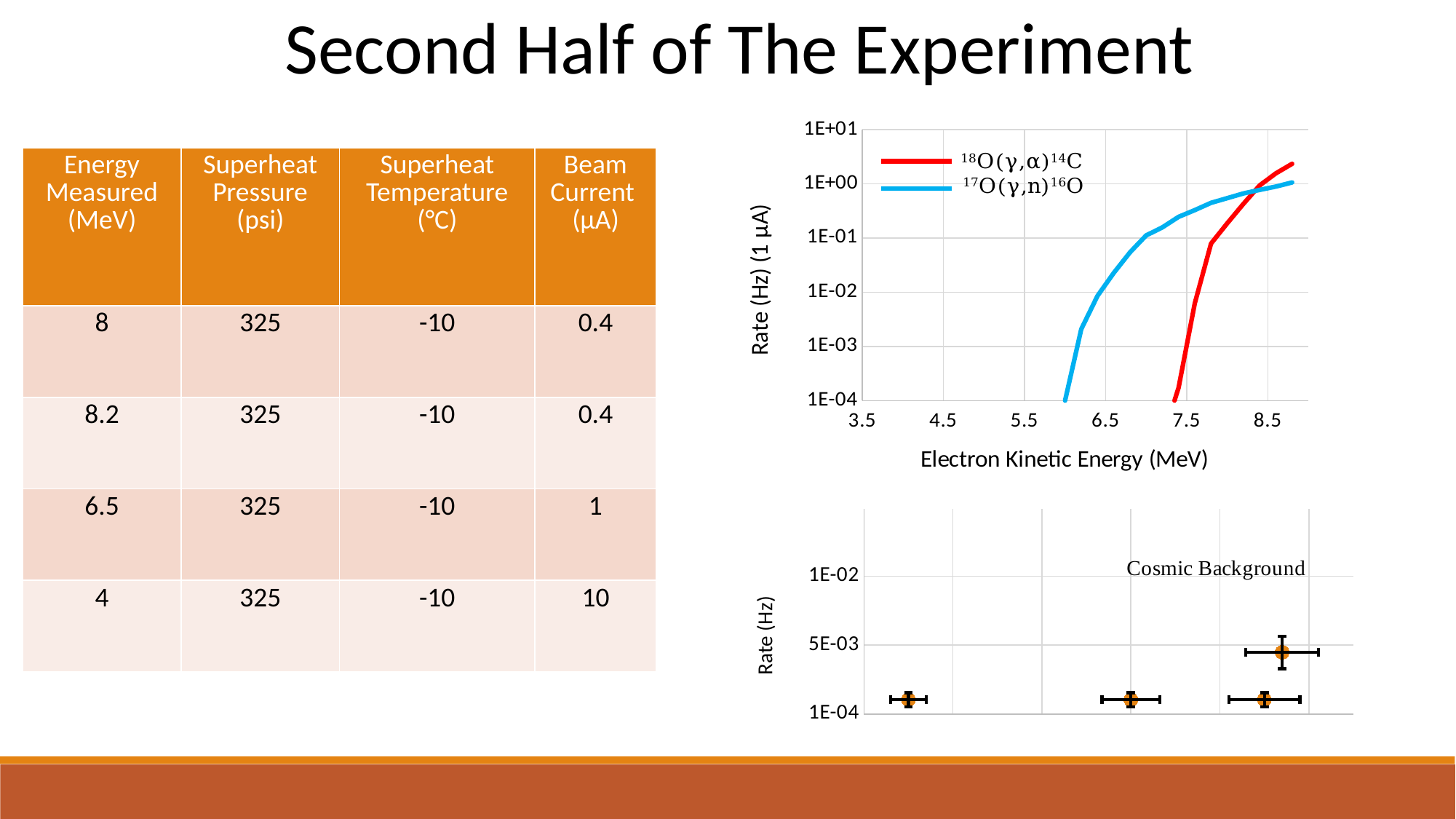
In the top-right chart, which series begins rising at a lower electron kinetic energy, 18O(γ,α)14C or 17O(γ,n)16O? 17O(γ,n)16O In the bottom-right Cosmic Background chart, is the highest data point greater or less than 1E-03? greater How many series does the legend of the top-right chart list? 2 How many data points are plotted in the bottom-right Cosmic Background chart? 4 What type of chart is the top-right chart with the Electron Kinetic Energy axis? line chart In the top-right chart, is the rate for the 17O(γ,n)16O series at 7.5 MeV greater or less than 1E-01? greater In the top-right chart, what is the x-axis label? Electron Kinetic Energy (MeV) In the top-right chart, does the rate for the 17O(γ,n)16O series rise or fall as electron kinetic energy increases? rise In the top-right chart, which series is drawn in red? 18O(γ,α)14C What is the title shown on the bottom-right chart? Cosmic Background In the top-right chart, which series has the higher rate at 8.5 MeV, 18O(γ,α)14C or 17O(γ,n)16O? 18O(γ,α)14C In the top-right chart, is the rate for the 18O(γ,α)14C series at 7.5 MeV greater or less than 1E-02? less